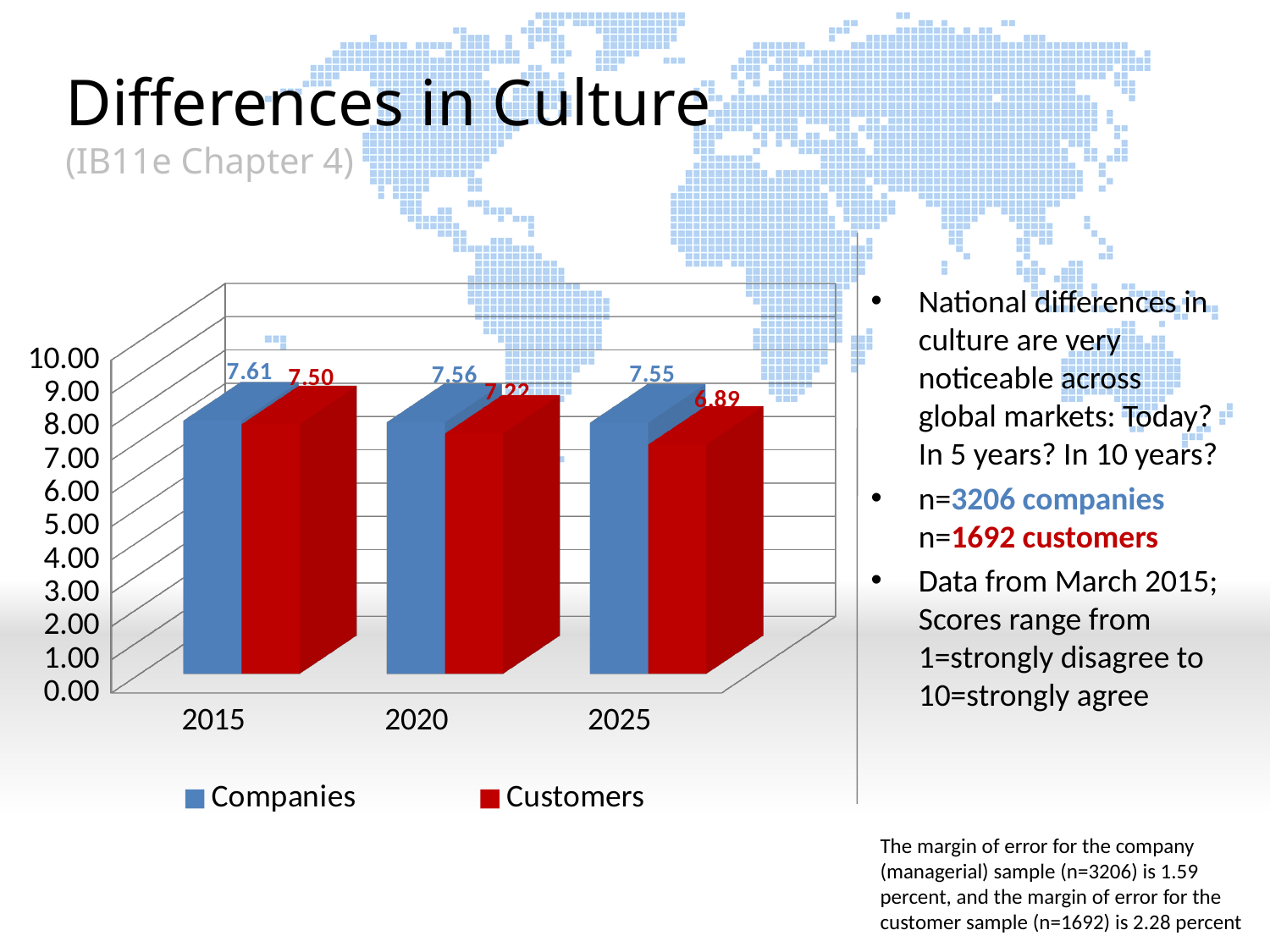
What kind of chart is shown on the slide? bar chart What is the value for Customers in 2015? 7.50 Do the Customers values rise or fall from 2015 to 2025? fall What is the value for Companies in 2025? 7.55 What is the value for Companies in 2015? 7.61 What is the difference between the Companies and Customers values in 2025? 0.66 In which year is the Customers value lowest? 2025 In which year is the Customers value highest? 2015 In 2015, which is larger: the Companies value or the Customers value? Companies What is the value for Customers in 2025? 6.89 How many years are shown on the x axis? 3 How many series does the legend list? 2